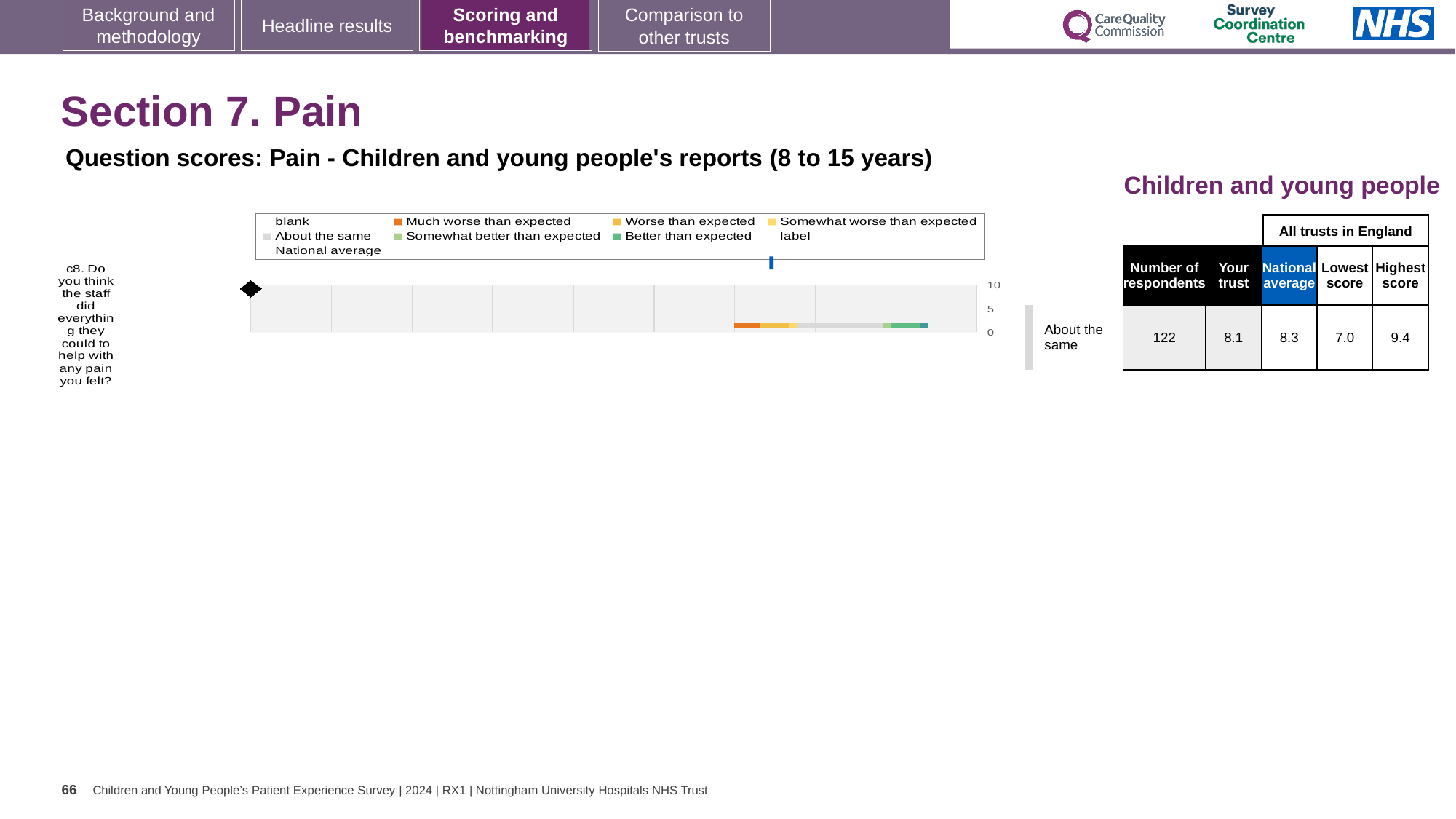
How many respondents answered question c8? 122 How many survey questions are plotted in the chart? 1 What is the lowest score among all trusts in England for question c8? 7.0 What kind of chart is shown on the slide? bar chart What benchmark category is shown for question c8? About the same What is the highest tick value shown on the chart's score axis? 10 What is the 'Your trust' score for question c8 about staff helping with pain? 8.1 What is the difference between the highest score and the lowest score for question c8? 2.4 What is the highest score among all trusts in England for question c8? 9.4 Which is larger for question c8: the 'Your trust' score or the national average? National average What is the national average score for question c8? 8.3